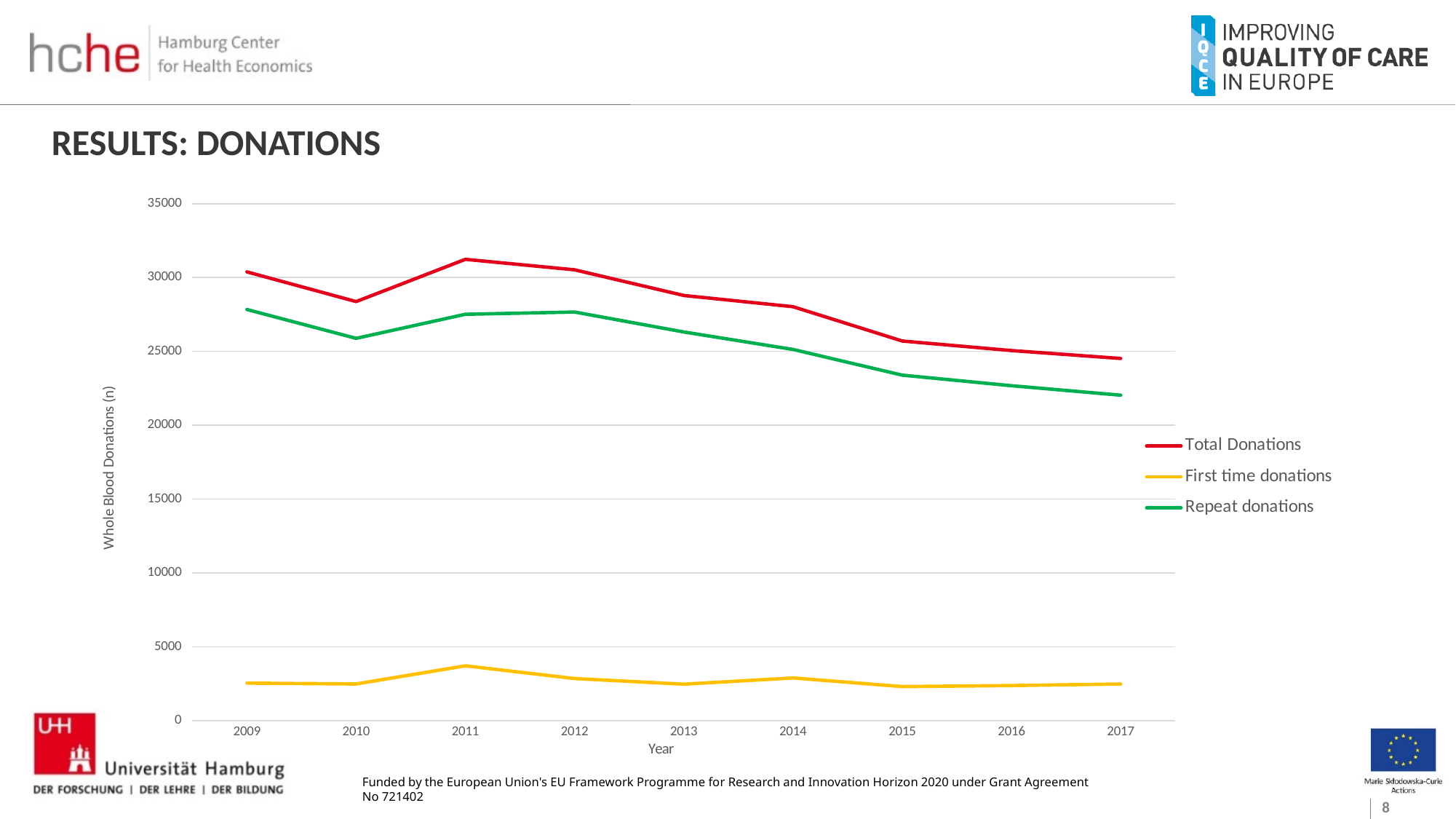
How many years are plotted along the x axis? 9 In which year is the Total Donations line at its highest? 2011 How many series does the legend list? 3 Which series has the larger value in 2014, Repeat donations or First time donations? Repeat donations Is the value for Repeat donations in 2017 greater or less than 25000? less What kind of chart is shown on the slide? line chart In which year is the Repeat donations line at its lowest? 2017 From 2012 to 2017, do the Total Donations values rise or fall? fall What is the label on the vertical axis? Whole Blood Donations (n) In which year is the Total Donations line at its lowest? 2017 Is the value for First time donations in 2011 greater or less than 5000? less Is the value for Total Donations in 2009 greater or less than 30000? greater